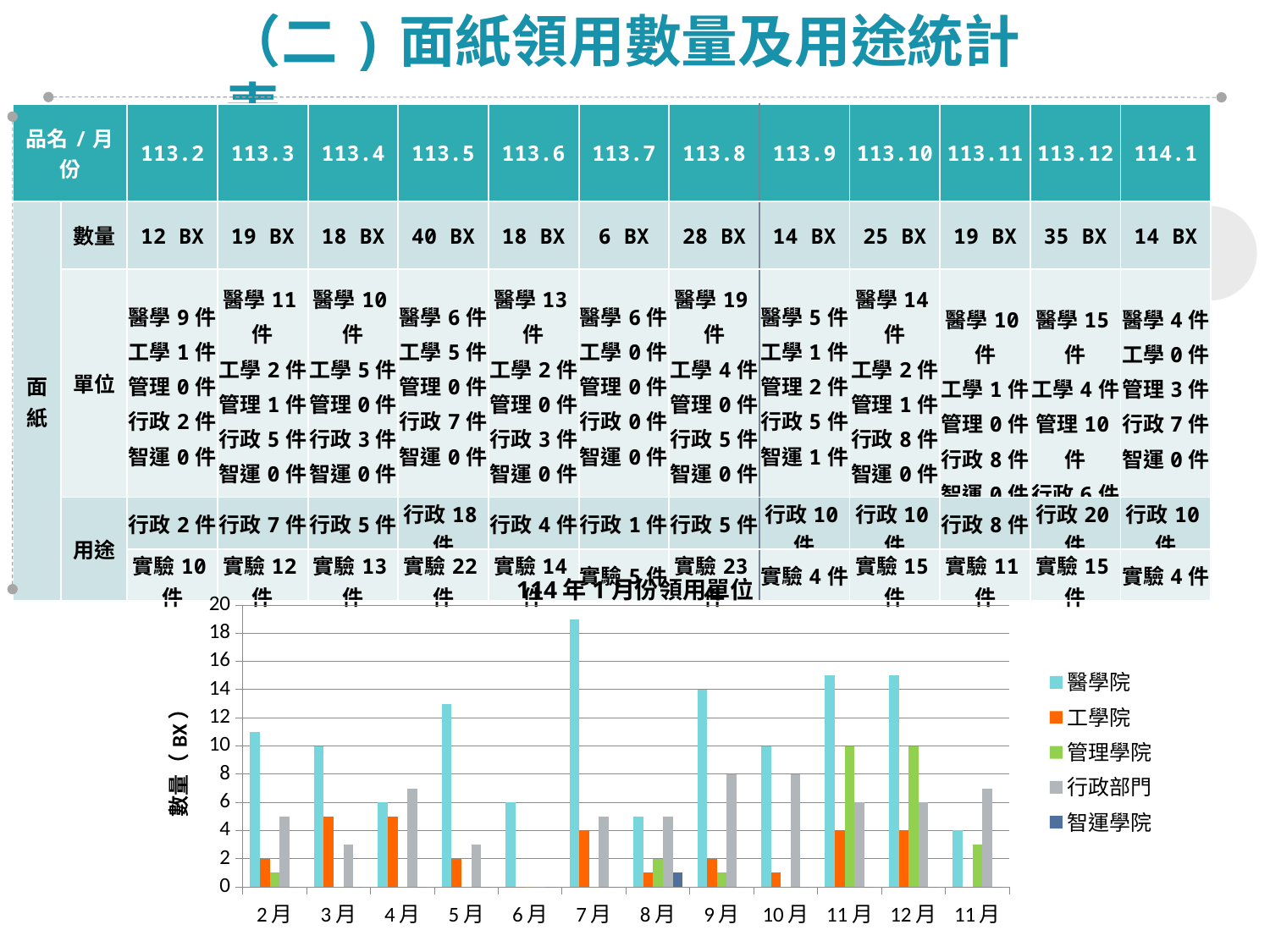
How many month categories are shown along the x axis of the bar chart? 12 In the bar chart, is the value for 醫學院 in 2月 greater or less than 10? greater What kind of chart is shown at the bottom of the slide? bar chart In the bar chart, which is larger: the 醫學院 value in 7月 or the 醫學院 value in 9月? 7月 In the bar chart, is the value for 行政部門 in 3月 greater or less than 4? less What is the y-axis title of the bar chart? 數量（BX） In the bar chart, is the value for 醫學院 in 7月 greater or less than 16? greater In the bar chart, which is larger in 11月 (the first 11月 category): 管理學院 or 工學院? 管理學院 Which series is shown in orange in the bar chart's legend? 工學院 In the bar chart, which month has the highest value for 醫學院? 7月 How many series does the legend of the bar chart list? 5